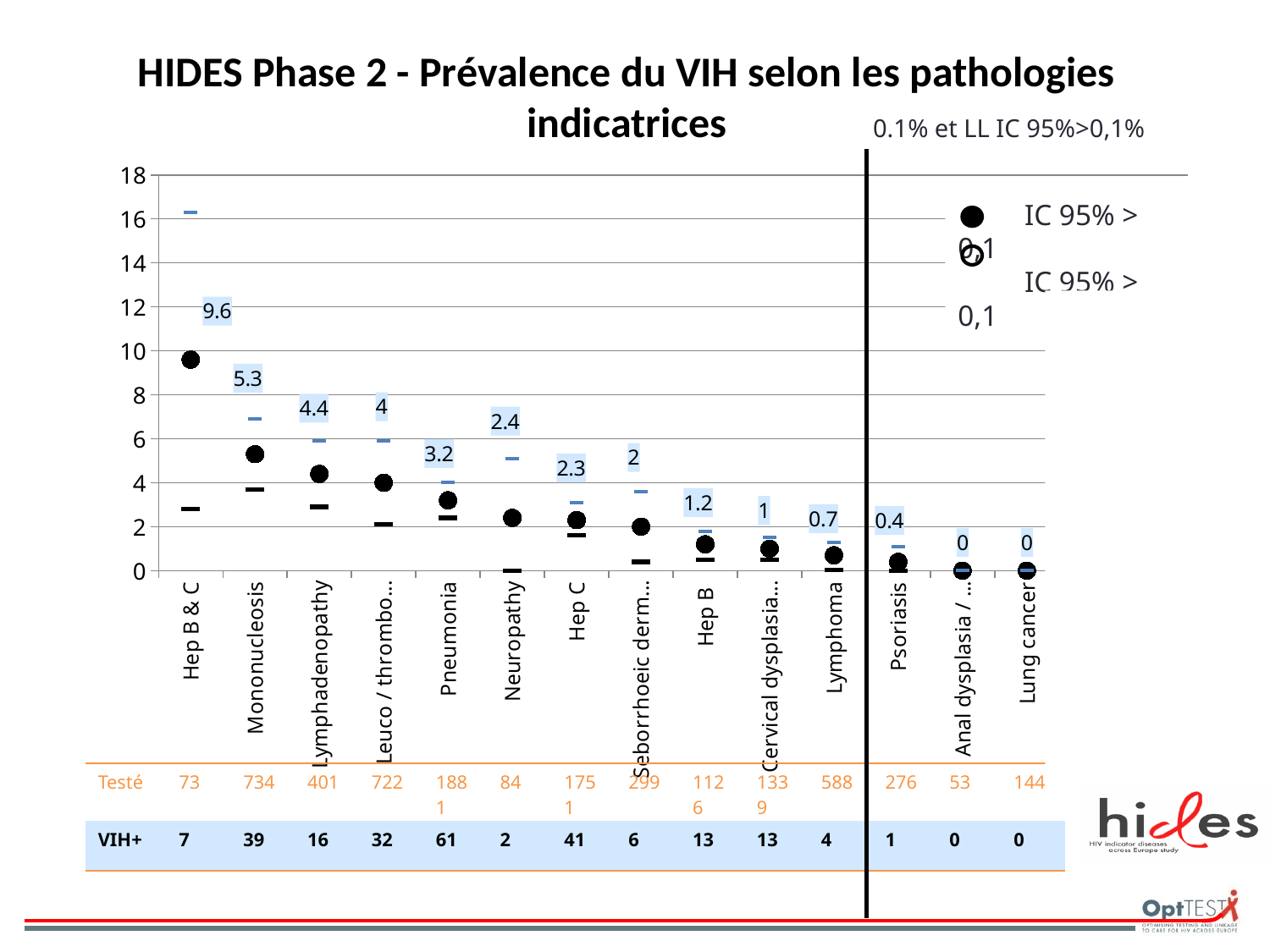
Is the plotted value for Lymphadenopathy greater or less than 4? greater What is the difference between the values for Hep B & C and Mononucleosis? 4.3 What is the value plotted for Pneumonia? 3.2 How many pathologies are plotted along the x axis? 14 Which pathology has the highest plotted prevalence value? Hep B & C Do the plotted values rise or fall from left to right along the x axis? fall What is the title of the chart? HIDES Phase 2 - Prévalence du VIH selon les pathologies indicatrices What is the value plotted for Psoriasis? 0.4 What is the value plotted for Mononucleosis? 5.3 What is the HIV prevalence value shown for Hep B & C? 9.6 Which has a larger plotted value, Neuropathy or Hep B? Neuropathy How many VIH+ cases are listed in the table for Mononucleosis? 39